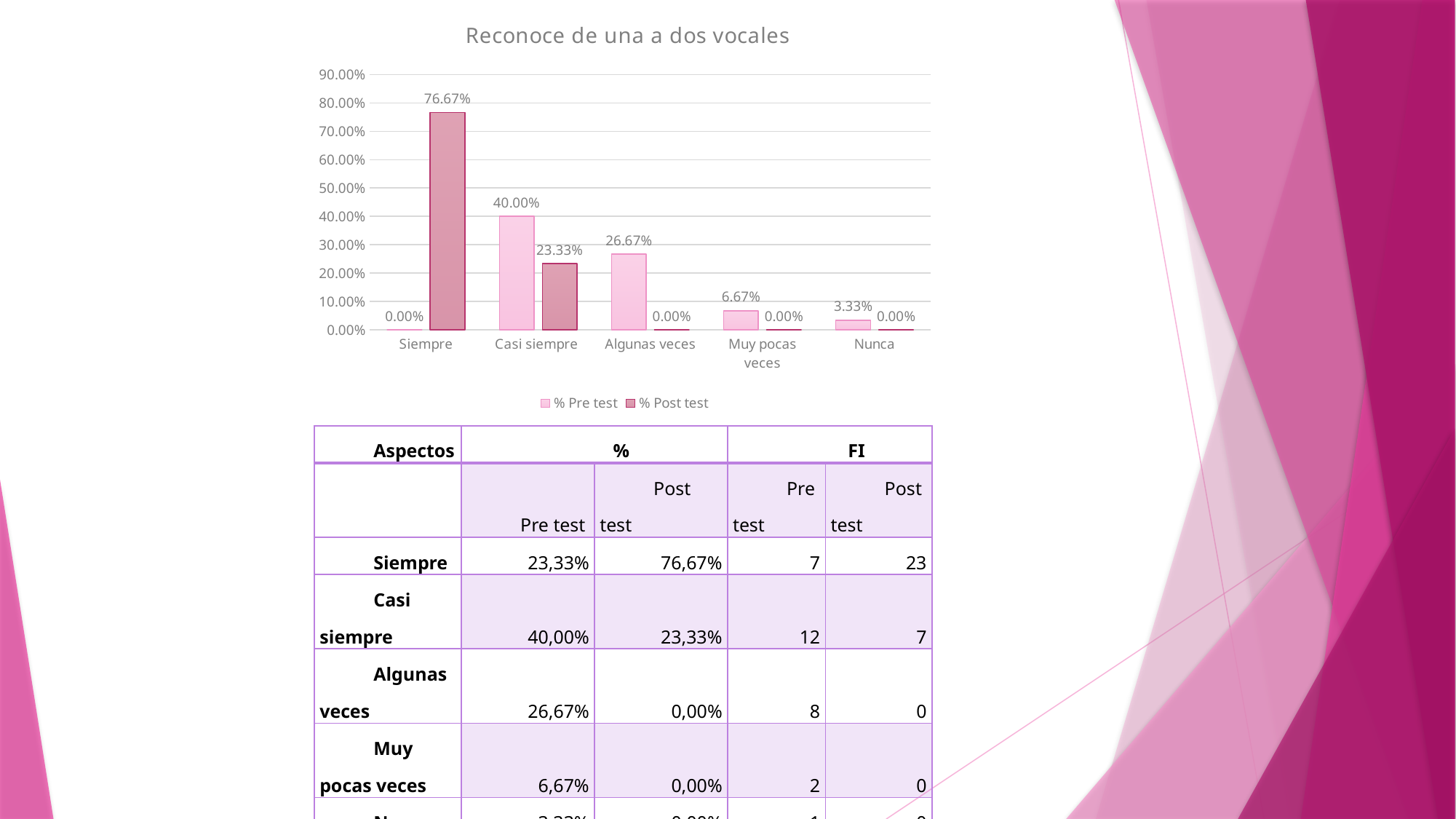
What is the % Pre test value for Algunas veces? 26.67% Which is larger for Algunas veces, the % Pre test value or the % Post test value? % Pre test How many categories are shown on the x axis of the chart? 5 What is the difference between the % Pre test and % Post test values for Casi siempre? 16.67% Which category has the highest % Pre test value? Casi siempre What type of chart is shown on the slide? Bar chart How many series does the chart legend list? 2 What is the % Pre test value for Nunca? 3.33% What is the % Post test value for Siempre? 76.67% What is the % Post test value for Casi siempre? 23.33% Which category has the highest % Post test value? Siempre What is the % Pre test value for Casi siempre? 40.00%